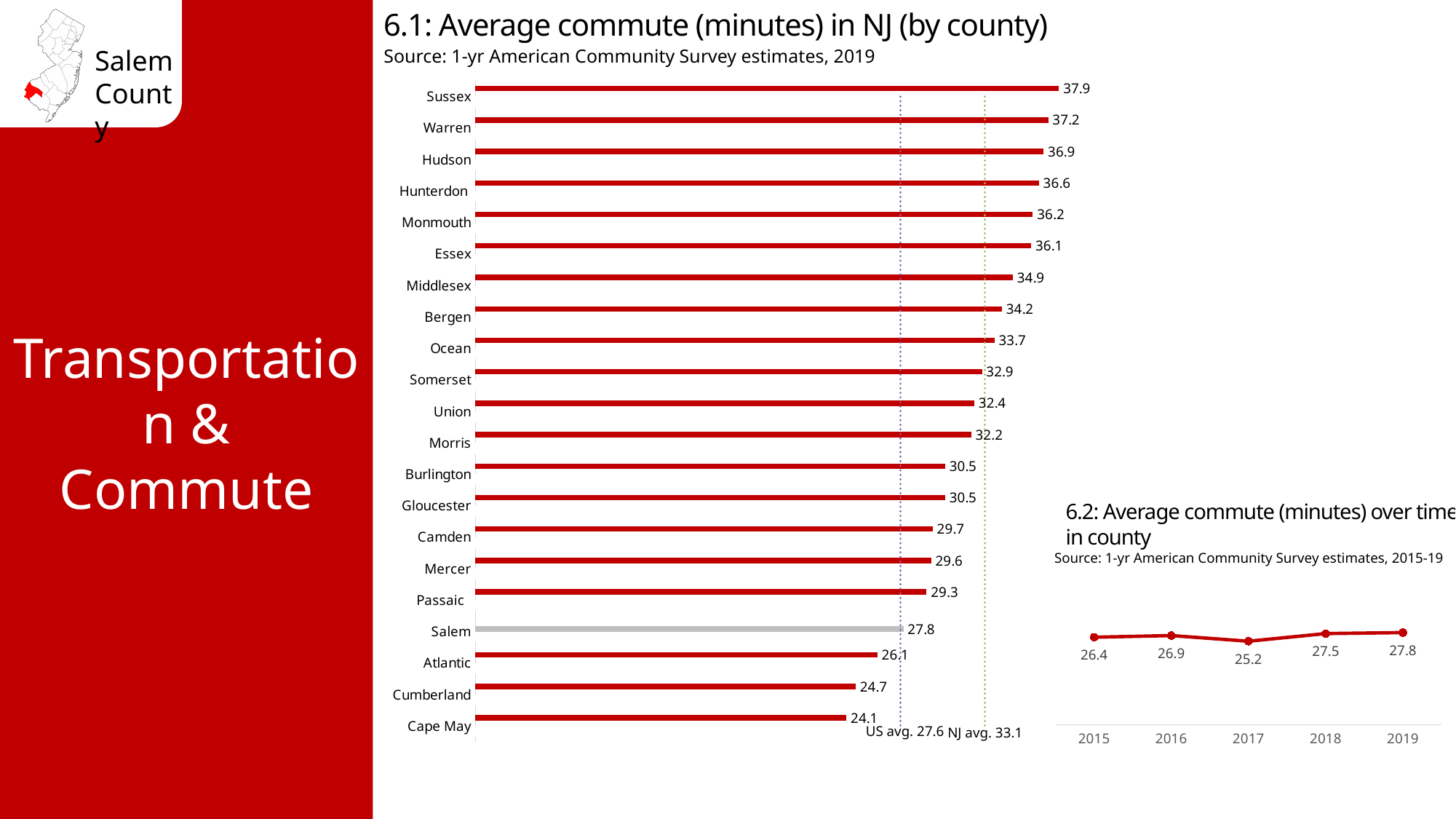
In chart 6.1 (Average commute in NJ by county), which county has the highest average commute? Sussex In chart 6.1 (Average commute in NJ by county), what NJ average is marked by the dotted reference line? 33.1 In chart 6.1 (Average commute in NJ by county), what is the average commute for Hudson? 36.9 In chart 6.1 (Average commute in NJ by county), what is the difference between Sussex and Salem? 10.1 In chart 6.2 (Average commute over time in county), what was the average commute in 2017? 25.2 What kind of chart is chart 6.1 (Average commute in NJ by county)? Bar chart In chart 6.2 (Average commute over time in county), which year had the highest average commute? 2019 In chart 6.1 (Average commute in NJ by county), which county has the lowest average commute? Cape May In chart 6.1 (Average commute in NJ by county), what is the average commute for Salem? 27.8 In chart 6.1 (Average commute in NJ by county), how many counties are shown? 21 In chart 6.1 (Average commute in NJ by county), which has a longer average commute, Bergen or Ocean? Bergen In chart 6.2 (Average commute over time in county), what is the difference between 2019 and 2015? 1.4